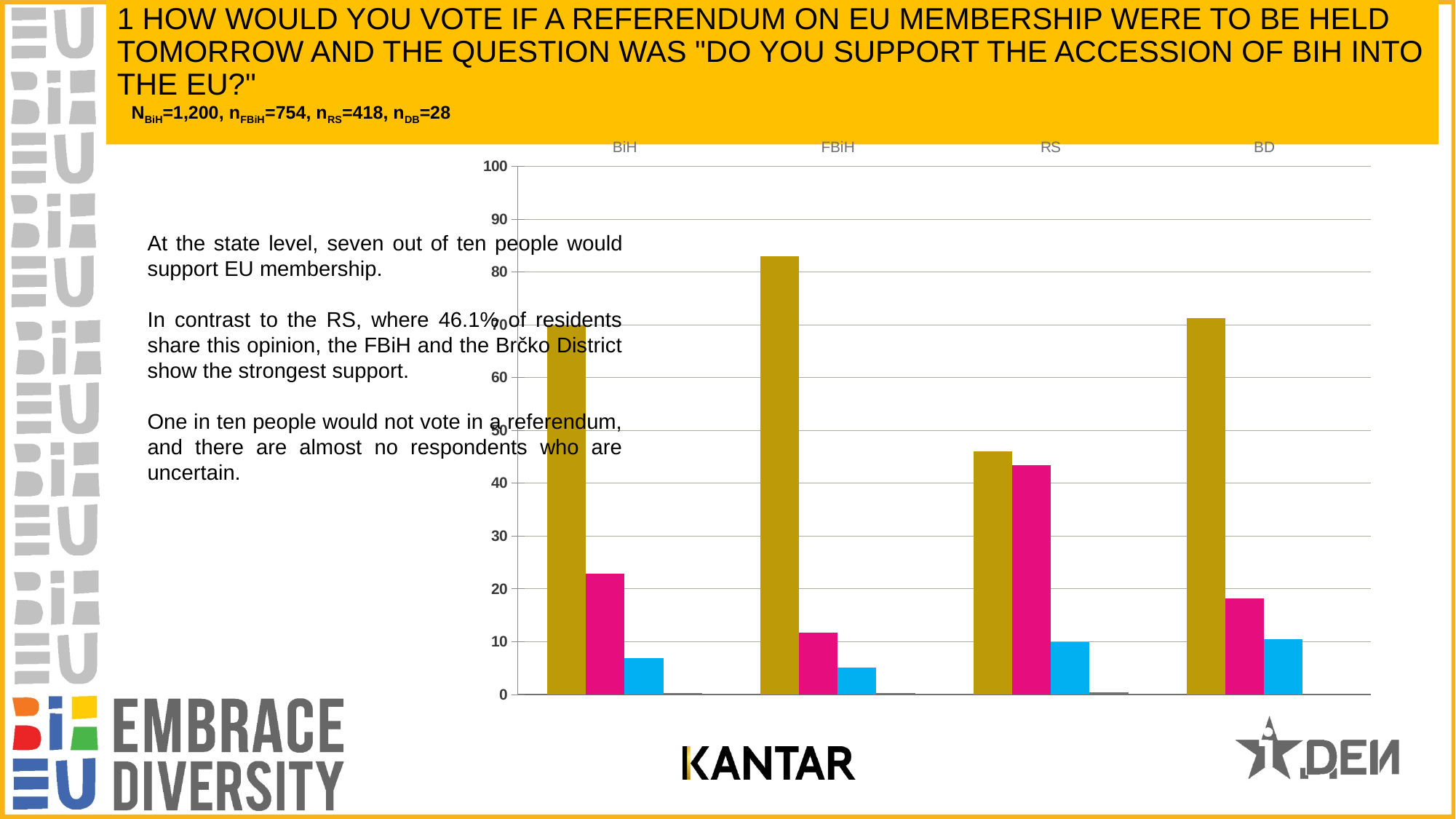
Is the value of the pink bar for BiH greater or less than 20? greater Which is larger in the BiH category, the gold bar or the pink bar? the gold bar In which category is the gold bar the shortest? RS In which category is the blue bar the shortest? FBiH How many categories are shown along the x axis of the chart? 4 Is the value of the blue bar for BiH greater or less than 10? less Is the value of the pink bar for BD greater or less than 20? less In which category is the pink bar the tallest? RS In which category is the gold bar the tallest? FBiH What kind of chart is shown on the slide? bar chart